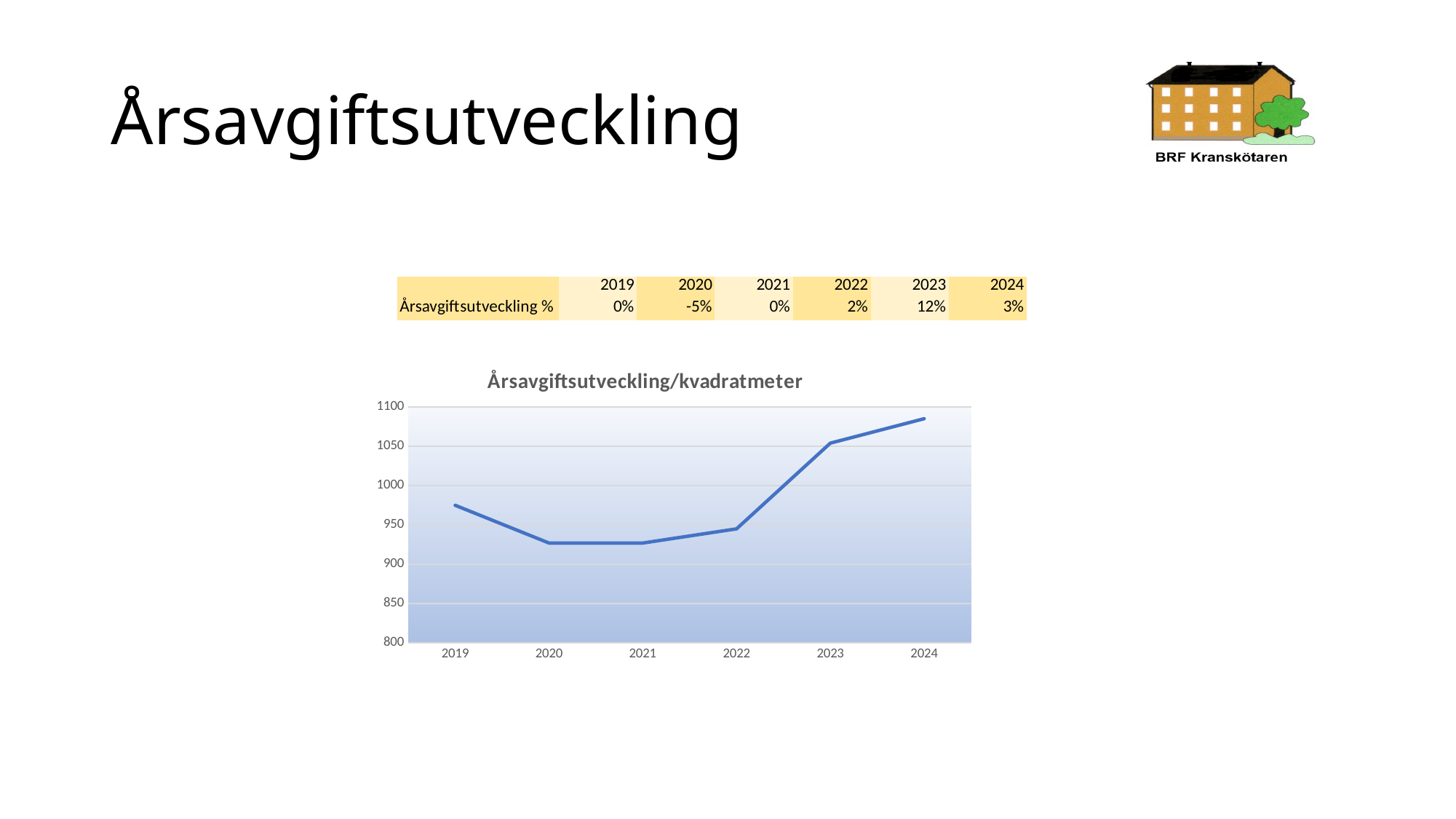
What kind of chart is shown on the slide? line chart Which year has the highest value in the chart? 2024 What is the title of the chart? Årsavgiftsutveckling/kvadratmeter Does the line rise or fall from 2021 to 2024? rise Is the value for 2024 greater or less than 1050? greater Is the value for 2023 greater or less than 1000? greater Is the value for 2019 greater or less than 950? greater How many years are plotted on the x axis of the chart? 6 Does the line rise or fall from 2019 to 2020? fall Which is larger, the value for 2019 or the value for 2022? 2019